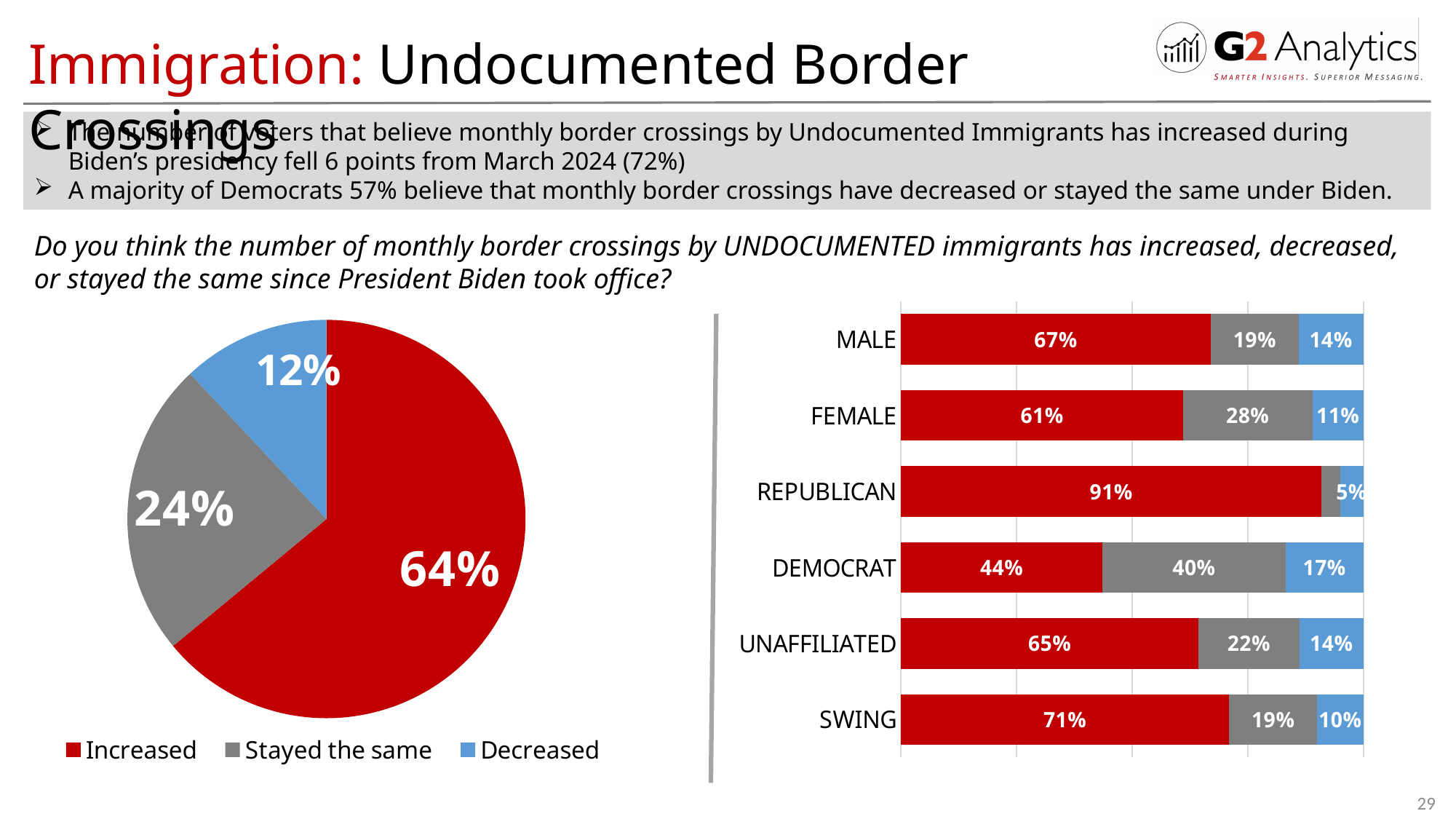
In the pie chart on the left, which response has the smallest slice? Decreased In the bar chart on the right, what percentage of Democrats said border crossings stayed the same? 40% In the bar chart on the right, which group has the highest percentage saying border crossings have increased? Republican In the bar chart on the right, which is larger: the percentage of Swing voters or Unaffiliated voters who said border crossings have increased? Swing In the bar chart on the right, how many groups are shown? 6 In the bar chart on the right, what percentage of Republicans said border crossings have increased? 91% In the pie chart on the left, what share of voters said border crossings have increased? 64% In the bar chart on the right, what is the difference between the percentage of males and females who said border crossings have increased? 6% In the bar chart on the right, which group has the lowest percentage saying border crossings have increased? Democrat In the pie chart on the left, what share of voters said border crossings stayed the same? 24% What kind of chart is the chart on the left of the slide? Pie chart How many entries does the legend of the pie chart on the left list? 3